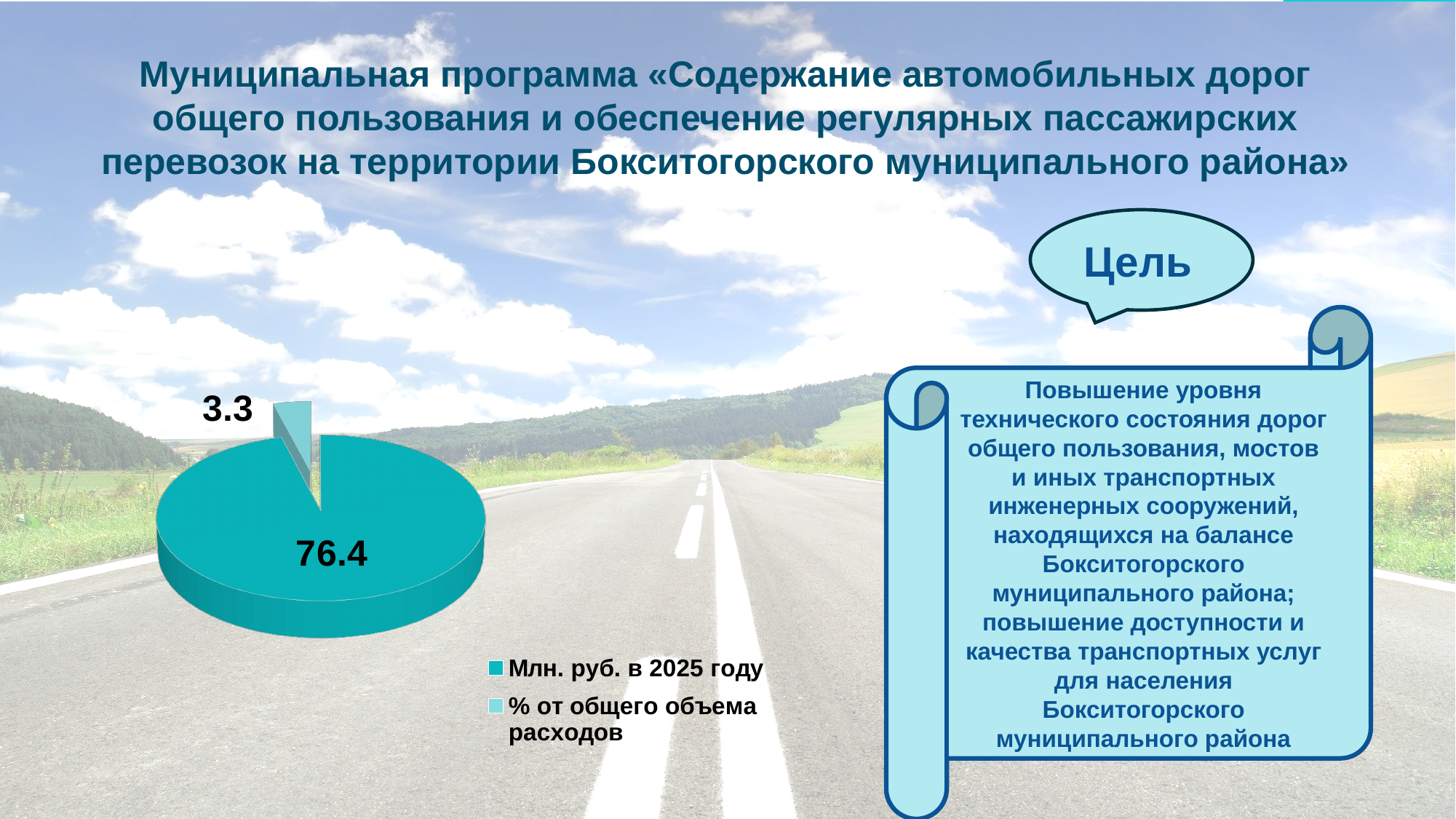
Which slice of the pie chart has the largest value? Млн. руб. в 2025 году What kind of chart is shown on the slide? pie chart Which is larger: the value for "Млн. руб. в 2025 году" or the value for "% от общего объема расходов"? Млн. руб. в 2025 году What colour is the slice labelled 76.4 in the pie chart? teal What is the difference between the two values shown on the pie chart, 76.4 and 3.3? 73.1 Which slice of the pie chart has the smallest value? % от общего объема расходов Which legend entry is shown in light blue? % от общего объема расходов How many slices does the pie chart have? 2 What value is shown for the slice labelled "Млн. руб. в 2025 году"? 76.4 What value is shown for the slice labelled "% от общего объема расходов"? 3.3 How many entries does the chart legend list? 2